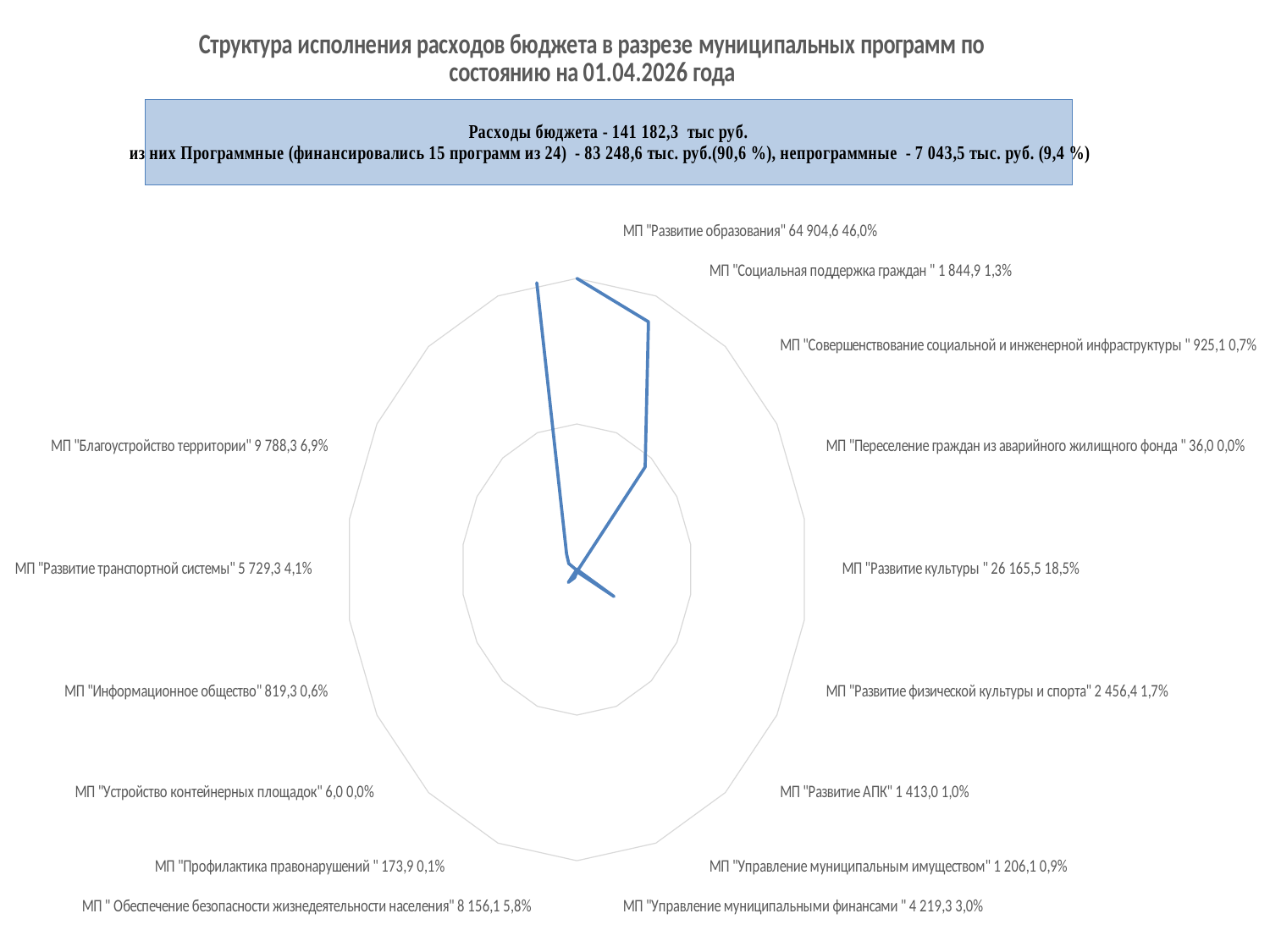
Which is larger: the value for МП "Развитие культуры" or for МП "Благоустройство территории"? МП "Развитие культуры" What percentage share is shown for МП "Обеспечение безопасности жизнедеятельности населения"? 5,8% Which municipal programme has the lowest value on the chart? МП "Устройство контейнерных площадок" What value is shown for МП "Развитие образования"? 64 904,6 What value is shown for МП "Благоустройство территории"? 9 788,3 Which municipal programme has the highest value on the chart? МП "Развитие образования" How many municipal programmes (categories) are plotted on the radar chart? 15 What type of chart is shown on the slide? Radar chart What percentage share is shown for МП "Развитие культуры"? 18,5% What is the difference between the values for МП "Развитие образования" and МП "Развитие культуры"? 38 739,1 What is the title of the chart on the slide? Структура исполнения расходов бюджета в разрезе муниципальных программ по состоянию на 01.04.2026 года What value is shown for МП "Управление муниципальными финансами"? 4 219,3